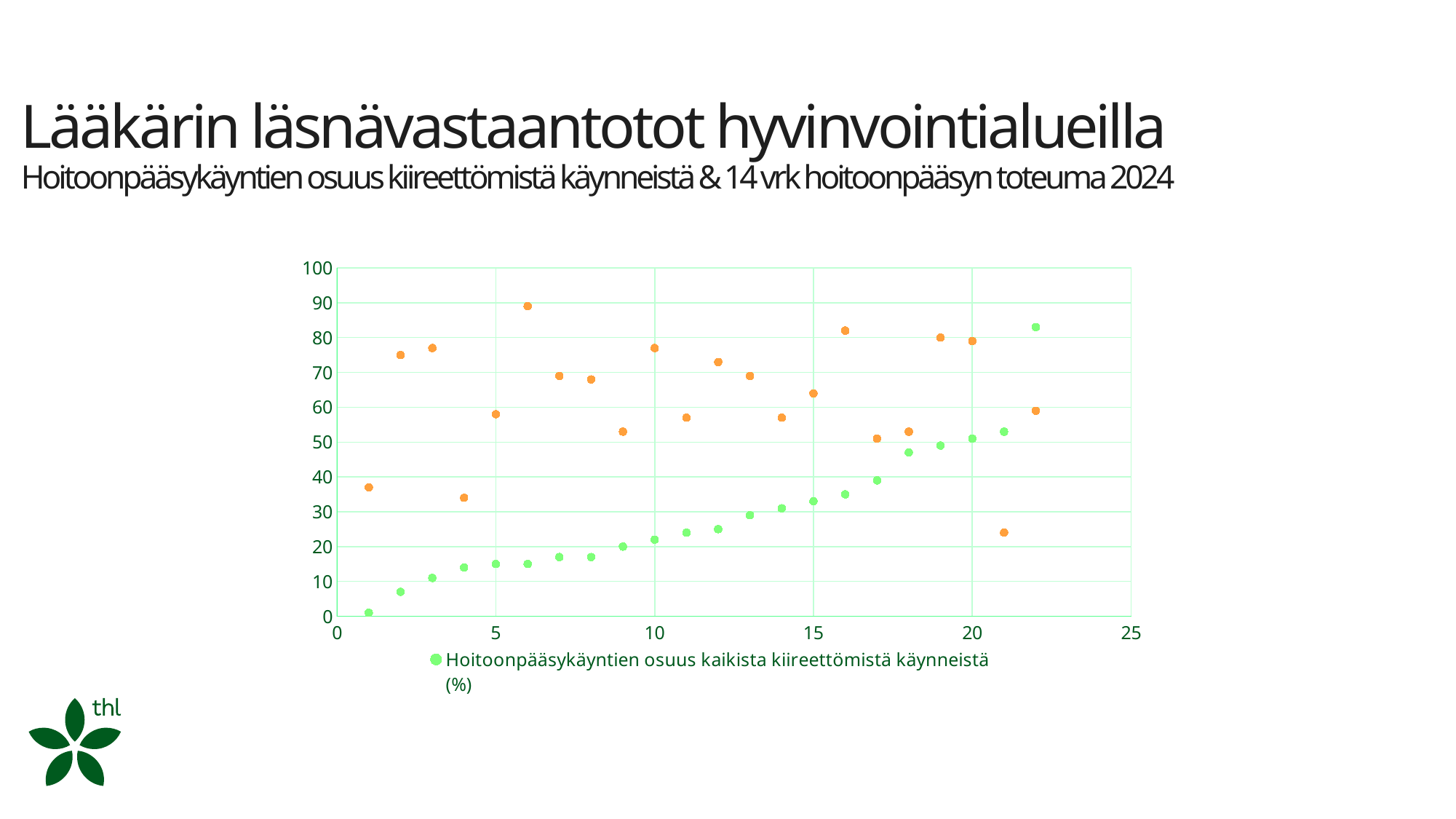
Is the green point at x = 1 greater or less than 10? less At x = 10, which point is higher, the orange or the green one? orange What is the title of the slide? Lääkärin läsnävastaantotot hyvinvointialueilla At which x-axis value is the highest orange point? 6 At which x-axis value is the highest green point? 22 How many green points are plotted on the chart? 22 What kind of chart is shown on the slide? scatter chart What series name does the legend show? Hoitoonpääsykäyntien osuus kaikista kiireettömistä käynneistä (%) Is the orange point at x = 6 greater or less than 80? greater At x = 22, which point is higher, the orange or the green one? green At which x-axis value is the lowest orange point? 21 Do the green points rise or fall as the x-axis value increases? rise